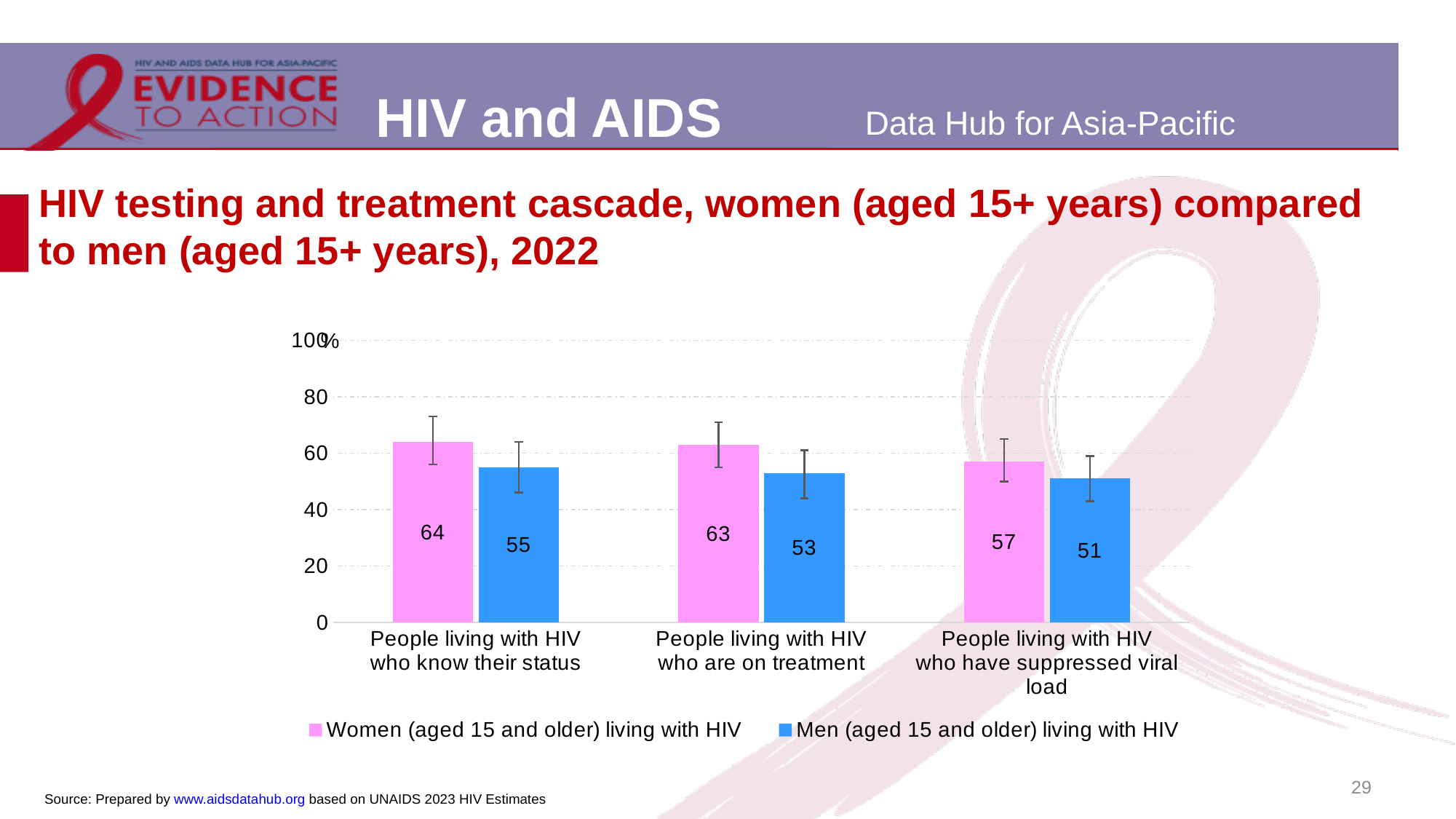
Which category has the highest value for women (aged 15 and older) living with HIV? People living with HIV who know their status How many categories are shown on the x axis? 3 Which category has the lowest value for men (aged 15 and older) living with HIV? People living with HIV who have suppressed viral load What is the value for women (aged 15 and older) living with HIV who know their status? 64 Do the values for women (aged 15 and older) living with HIV rise or fall across the categories from left to right? Fall What is the value for men (aged 15 and older) living with HIV who know their status? 55 What is the value for women (aged 15 and older) living with HIV who have suppressed viral load? 57 What is the difference between the women and men values for people living with HIV who are on treatment? 10 What is the value for men (aged 15 and older) living with HIV who are on treatment? 53 What kind of chart is shown on the slide? Bar chart How many series does the legend list? 2 Which is larger for people living with HIV who have suppressed viral load: the value for women or for men? Women